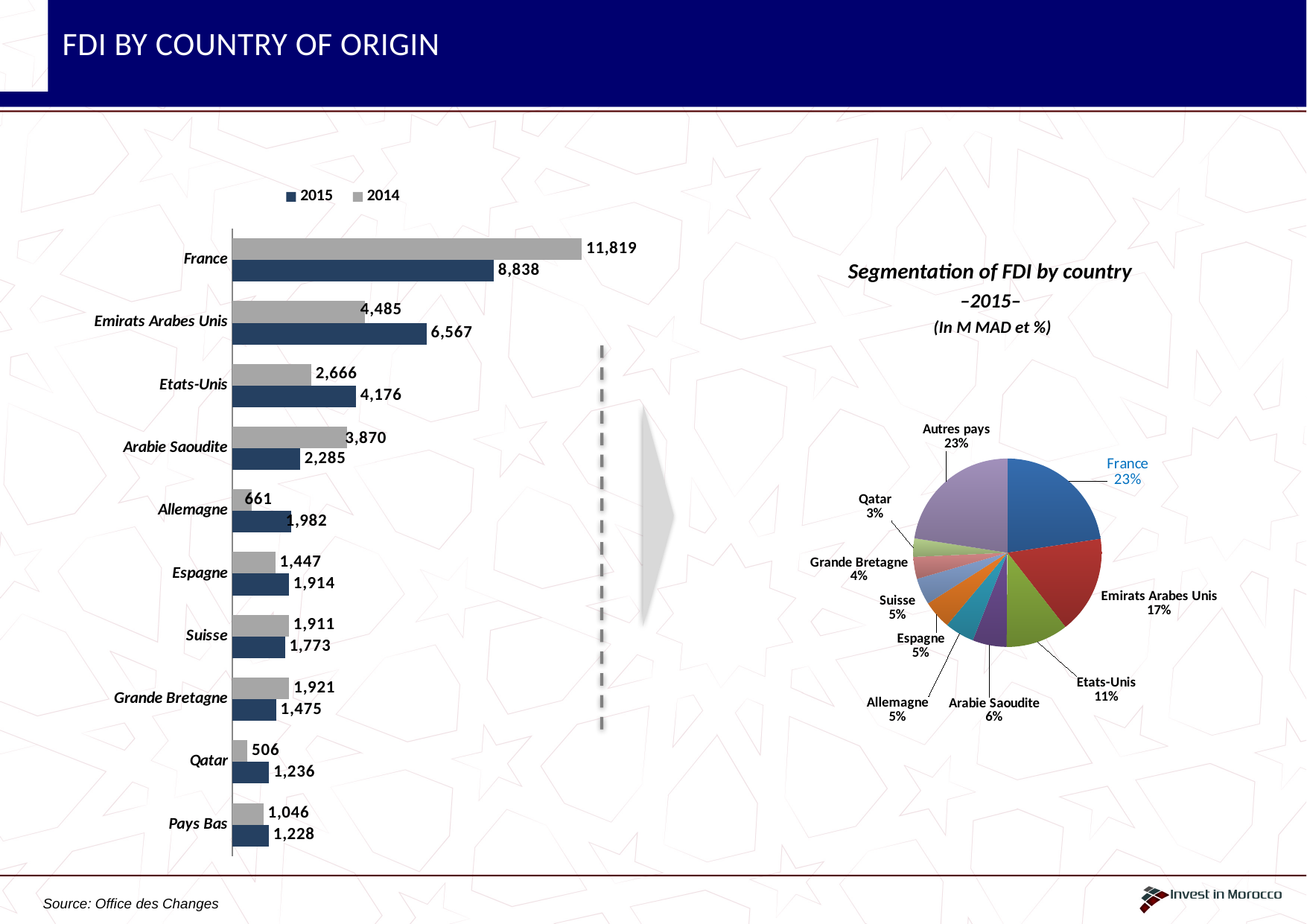
In the bar chart on the left, what is the 2014 value for Emirats Arabes Unis? 4,485 What is the title of the pie chart on the right? Segmentation of FDI by country –2015– In the bar chart on the left, what is the difference between the 2014 and 2015 values for France? 2,981 In the bar chart on the left, which country has the highest 2014 value? France In the pie chart 'Segmentation of FDI by country –2015–', what share does Emirats Arabes Unis have? 17% What kind of chart is the chart on the left of the slide? bar chart In the bar chart on the left, is the 2015 value for Etats-Unis larger or smaller than its 2014 value? larger How many series does the legend of the bar chart on the left list? 2 In the bar chart on the left, what is the 2015 value for France? 8,838 In the pie chart 'Segmentation of FDI by country –2015–', which country has the smallest share? Qatar In the bar chart on the left, which country has the lowest 2014 value? Qatar How many countries are shown in the bar chart on the left? 10